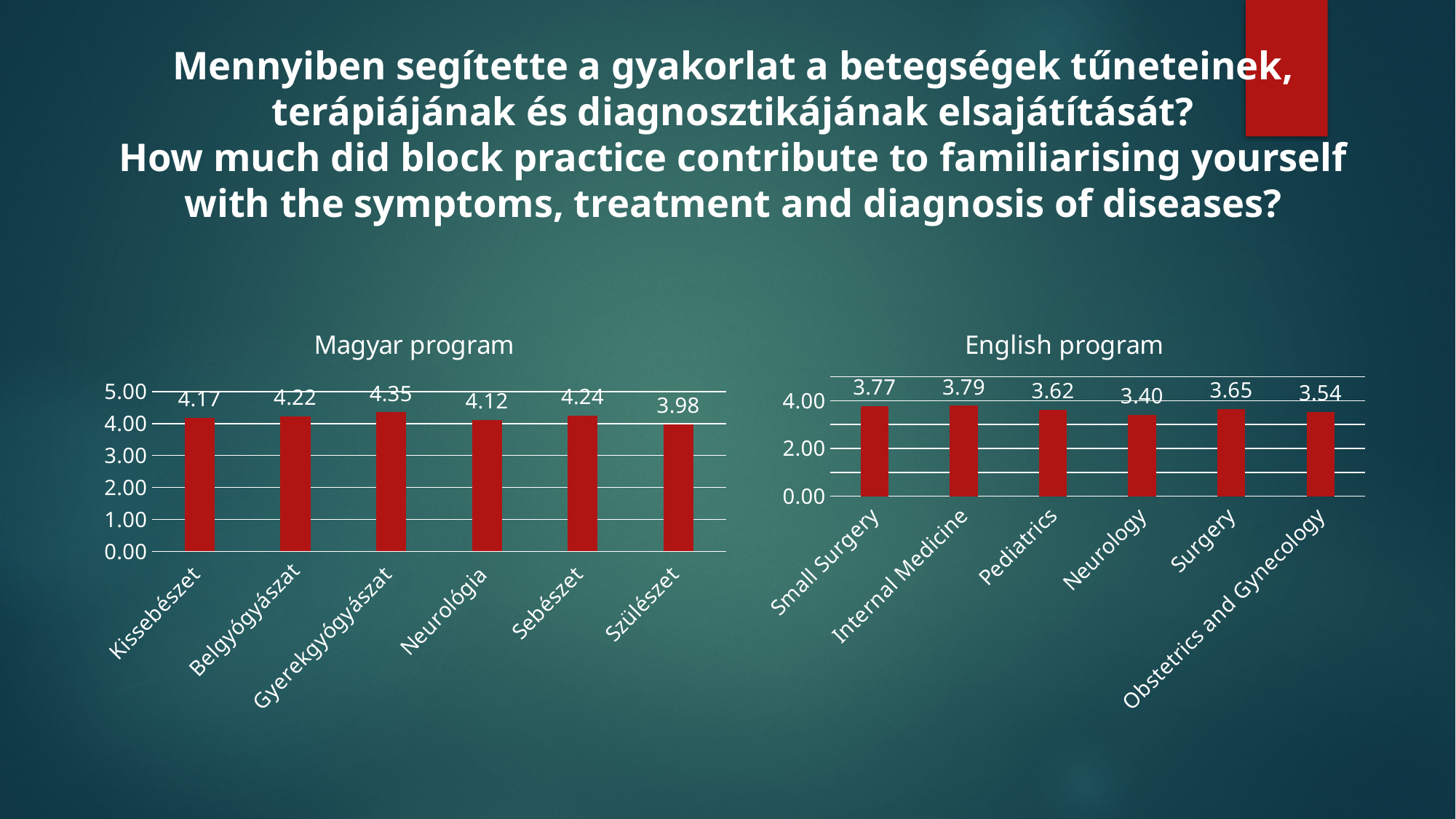
In the 'Magyar program' chart, what is the difference between the values for Gyerekgyógyászat and Szülészet? 0.37 In the 'English program' chart, what is the difference between the values for Internal Medicine and Neurology? 0.39 In the 'Magyar program' chart, which category has the lowest value? Szülészet In the 'Magyar program' chart, which is larger, the value for Sebészet or the value for Neurológia? Sebészet In the 'English program' chart, is the value for Pediatrics greater or less than 4.00? less In the 'English program' chart, which category has the lowest value? Neurology In the 'English program' chart, what is the value for Neurology? 3.40 How many categories are shown in the 'English program' chart? 6 In the 'Magyar program' chart, which category has the highest value? Gyerekgyógyászat What is the title of the chart on the right side of the slide? English program In the 'Magyar program' chart, what is the value for Gyerekgyógyászat? 4.35 What kind of chart is the 'Magyar program' chart? bar chart